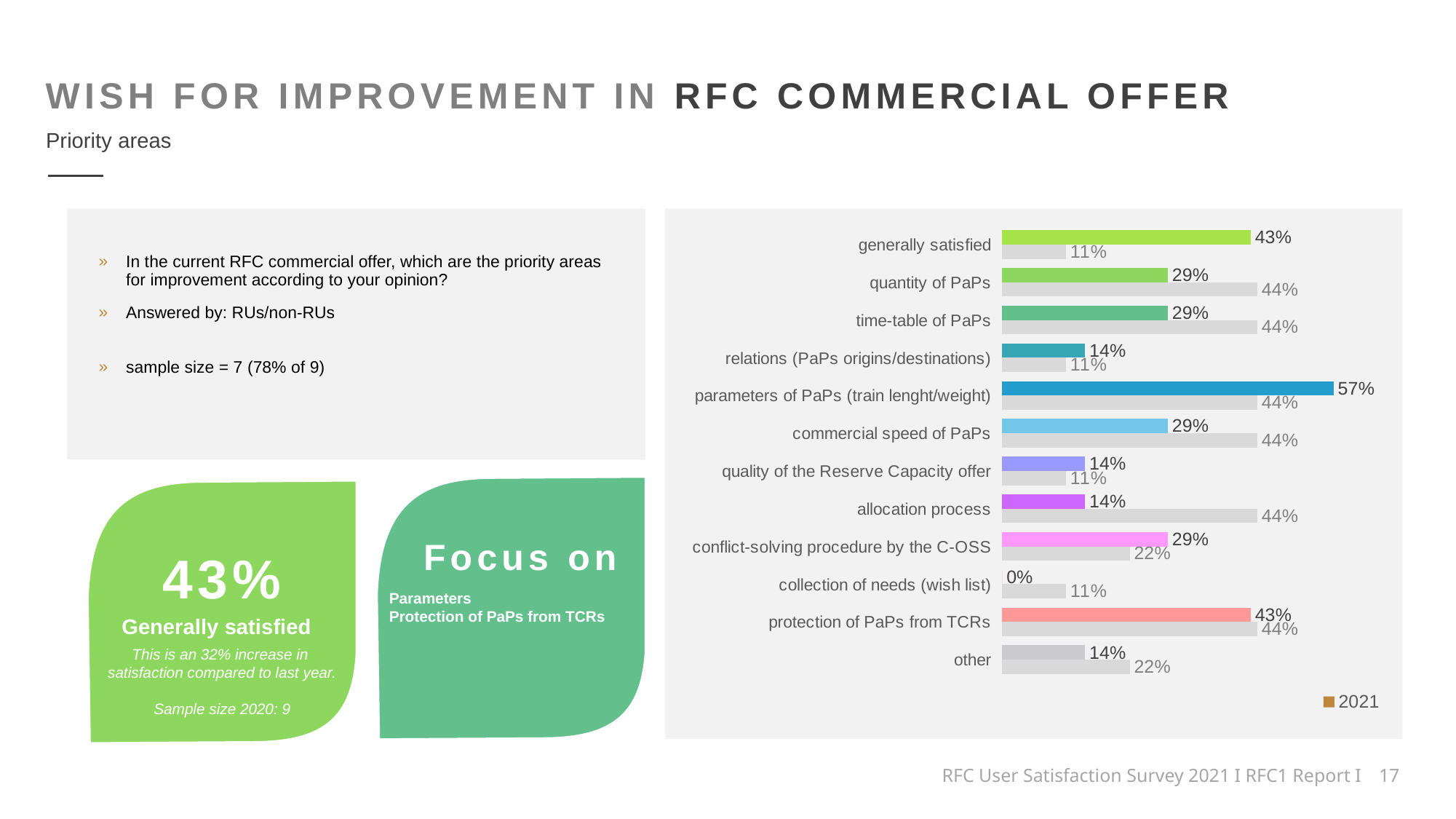
How many series does the legend list? 1 Which category has the highest 2021 value? parameters of PaPs (train lenght/weight) What is the value of the grey bar for "conflict-solving procedure by the C-OSS"? 22% What is the 2021 value for "other"? 14% How many categories are shown on the chart? 12 Which has the larger 2021 value: "quantity of PaPs" or "protection of PaPs from TCRs"? protection of PaPs from TCRs What kind of chart is shown on the slide? bar chart What is the difference between the 2021 values for "parameters of PaPs (train lenght/weight)" and "generally satisfied"? 14 percentage points What is the 2021 value for "parameters of PaPs (train lenght/weight)"? 57% Which category has the lowest 2021 value? collection of needs (wish list) What entry does the chart legend show? 2021 What is the 2021 value for "allocation process"? 14%